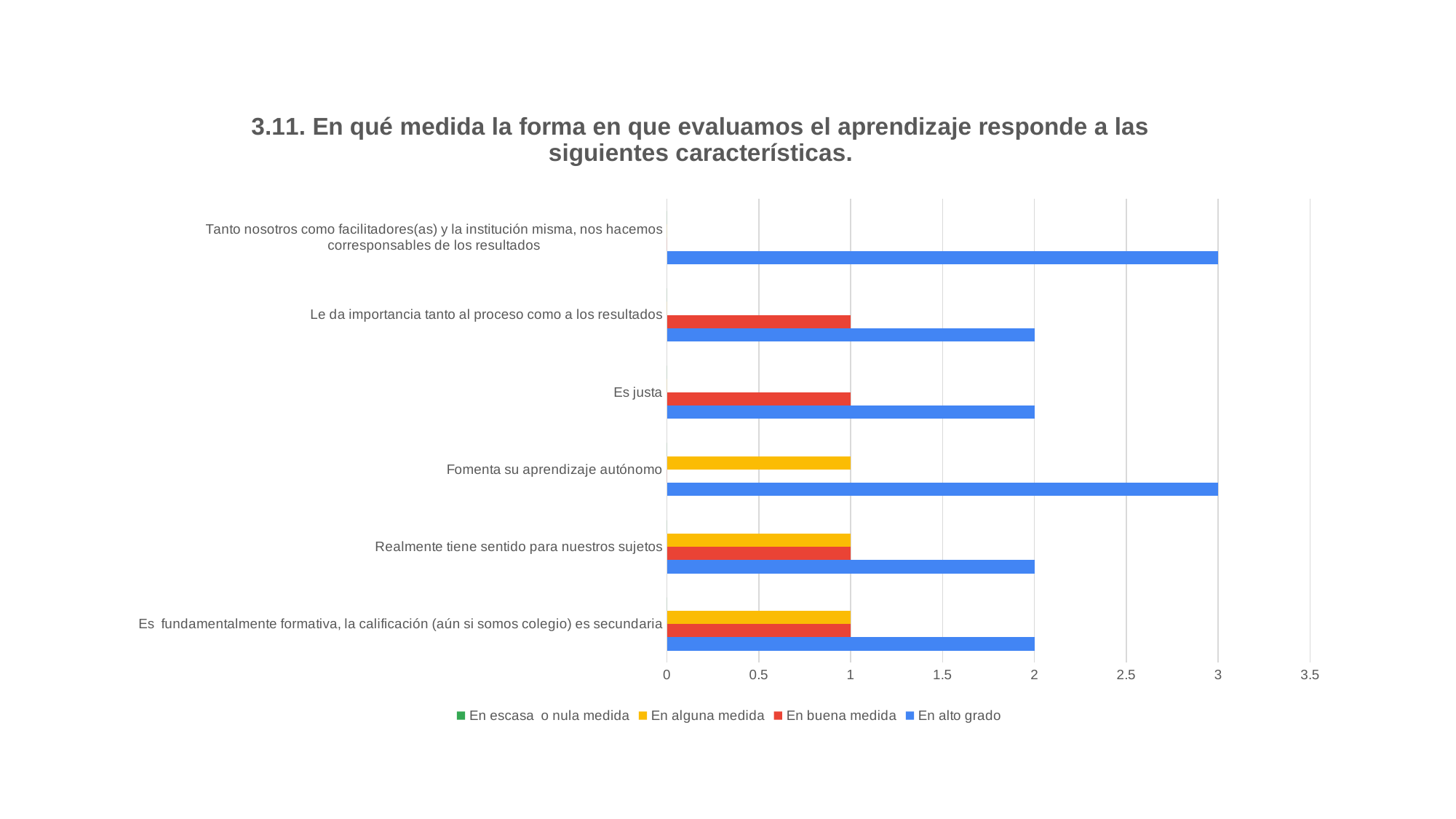
What kind of chart is shown on the slide? bar chart Is the 'En alto grado' value for 'Es fundamentalmente formativa, la calificación (aún si somos colegio) es secundaria' greater or less than 3? less What is the value of 'En alto grado' for 'Fomenta su aprendizaje autónomo'? 3 Which is larger: the 'En alto grado' value for 'Tanto nosotros como facilitadores(as) y la institución misma, nos hacemos corresponsables de los resultados' or for 'Le da importancia tanto al proceso como a los resultados'? Tanto nosotros como facilitadores(as) y la institución misma, nos hacemos corresponsables de los resultados How many categories are plotted on the chart? 6 What is the value of 'En alguna medida' for 'Realmente tiene sentido para nuestros sujetos'? 1 What is the difference between the 'En alto grado' values for 'Fomenta su aprendizaje autónomo' and 'Es justa'? 1 What is the value of 'En buena medida' for 'Le da importancia tanto al proceso como a los resultados'? 1 What is the total of all series for 'Realmente tiene sentido para nuestros sujetos'? 4 Which legend entry is shown in blue? En alto grado How many series does the legend list? 4 What is the value of 'En alto grado' for 'Es justa'? 2